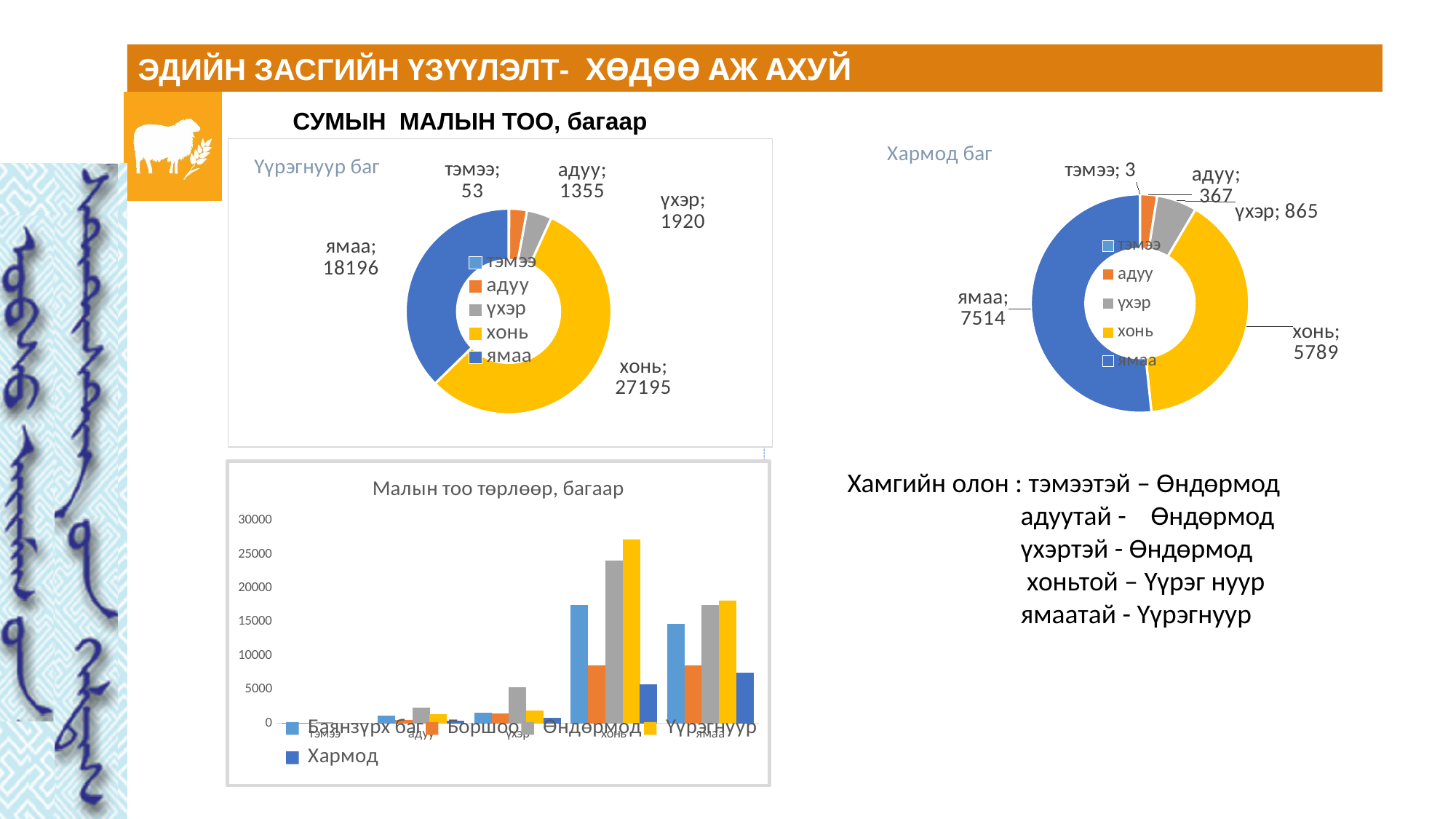
How many categories does the Хармод баг doughnut chart show? 5 On the Хармод баг doughnut chart, what is the value for ямаа? 7514 On the chart titled 'Малын тоо төрлөөр, багаар', how many series does the legend list? 5 On the Үүрэгнуур баг doughnut chart, which category has the highest value? хонь On the Хармод баг doughnut chart, which category has the lowest value? тэмээ On the chart titled 'Малын тоо төрлөөр, багаар', is the value for Өндөрмод in the хонь category greater or less than 25000? less On the Үүрэгнуур баг doughnut chart, what is the difference between хонь and ямаа? 8999 On the Үүрэгнуур баг doughnut chart, what is the value for хонь? 27195 On the Хармод баг doughnut chart, what is the difference between ямаа and хонь? 1725 What kind of chart is 'Малын тоо төрлөөр, багаар'? bar chart On the Хармод баг doughnut chart, which is larger, хонь or ямаа? ямаа On the Үүрэгнуур баг doughnut chart, what is the value for тэмээ? 53